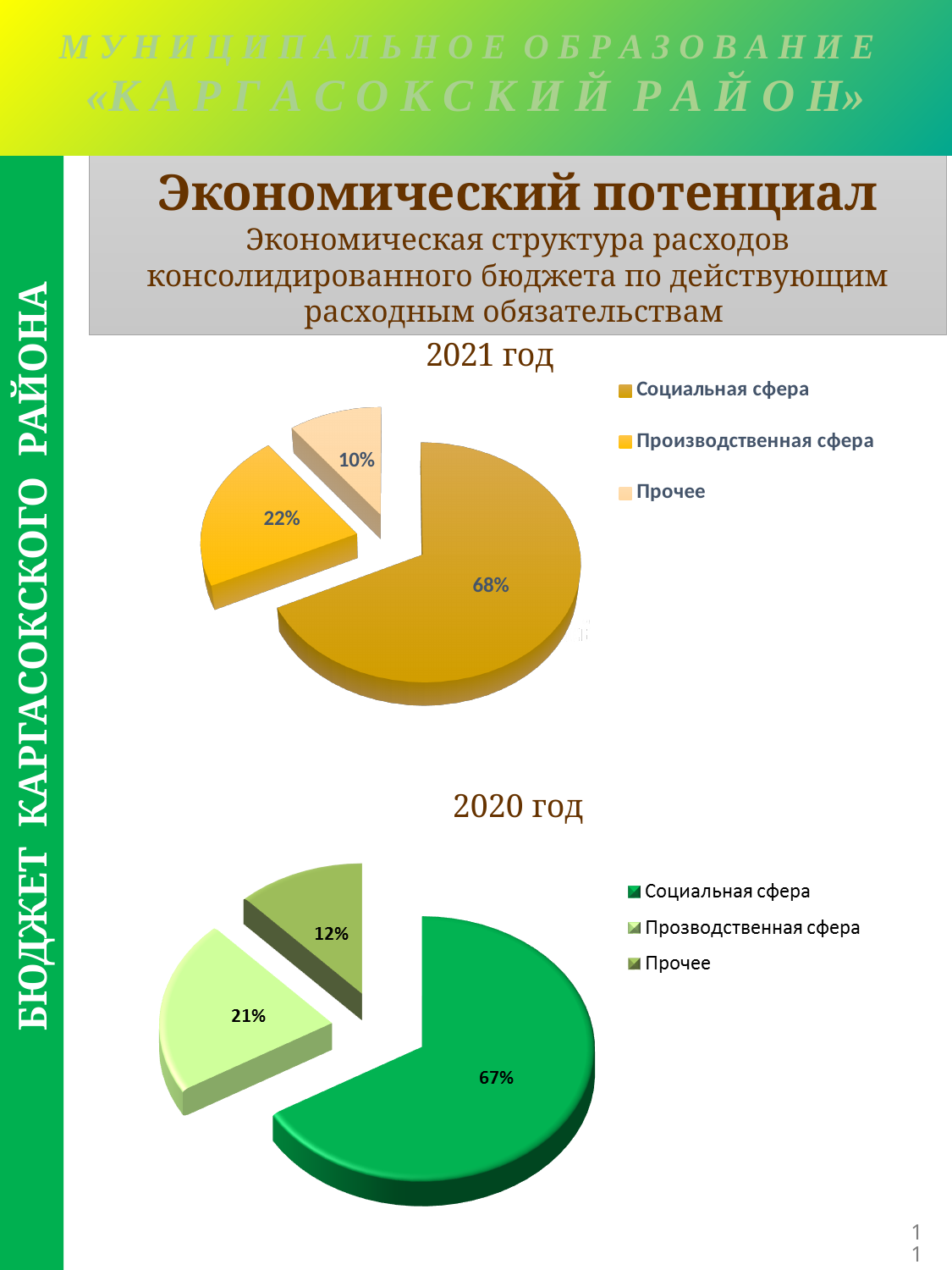
What type of chart is the 2021 год chart? Pie chart In the 2020 год chart, what share does Прочее have? 12% In the 2020 год chart, which is larger: Прозводственная сфера or Прочее? Прозводственная сфера How many entries does the legend of the 2021 год chart list? 3 In the 2021 год chart, which category has the smallest slice? Прочее In the 2021 год chart, what share does Прочее have? 10% How many slices does the 2020 год chart have? 3 In the 2020 год chart, what share does Социальная сфера have? 67% In the 2021 год chart, what share does Производственная сфера have? 22% In the 2021 год chart, what is the difference between the shares of Производственная сфера and Прочее? 12% In the 2020 год chart, which category has the largest slice? Социальная сфера In the 2021 год chart, what share does Социальная сфера have? 68%